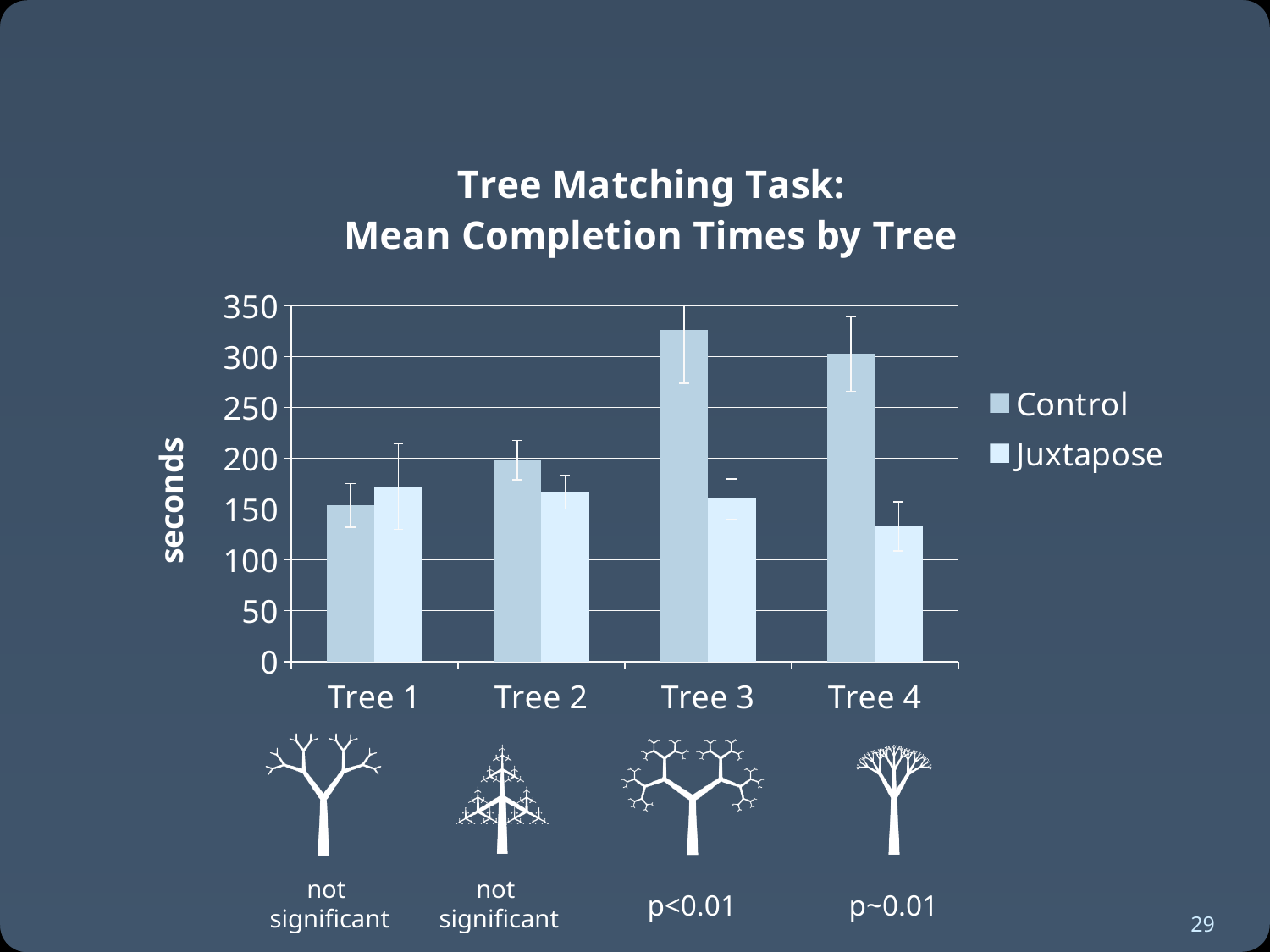
For which tree is the Juxtapose completion time lowest? Tree 4 For which tree is the Control completion time lowest? Tree 1 What kind of chart is shown on the slide? bar chart How many series does the legend list? 2 Is the Juxtapose value for Tree 4 greater or less than 150? less For Tree 4, which series has the larger completion time, Control or Juxtapose? Control How many tree categories are shown on the x axis? 4 For Tree 1, which series has the larger completion time, Control or Juxtapose? Juxtapose For which tree is the Control completion time highest? Tree 3 What is the label on the vertical axis? seconds Is the Juxtapose value for Tree 3 greater or less than 200? less Is the Control value for Tree 3 greater or less than 300? greater